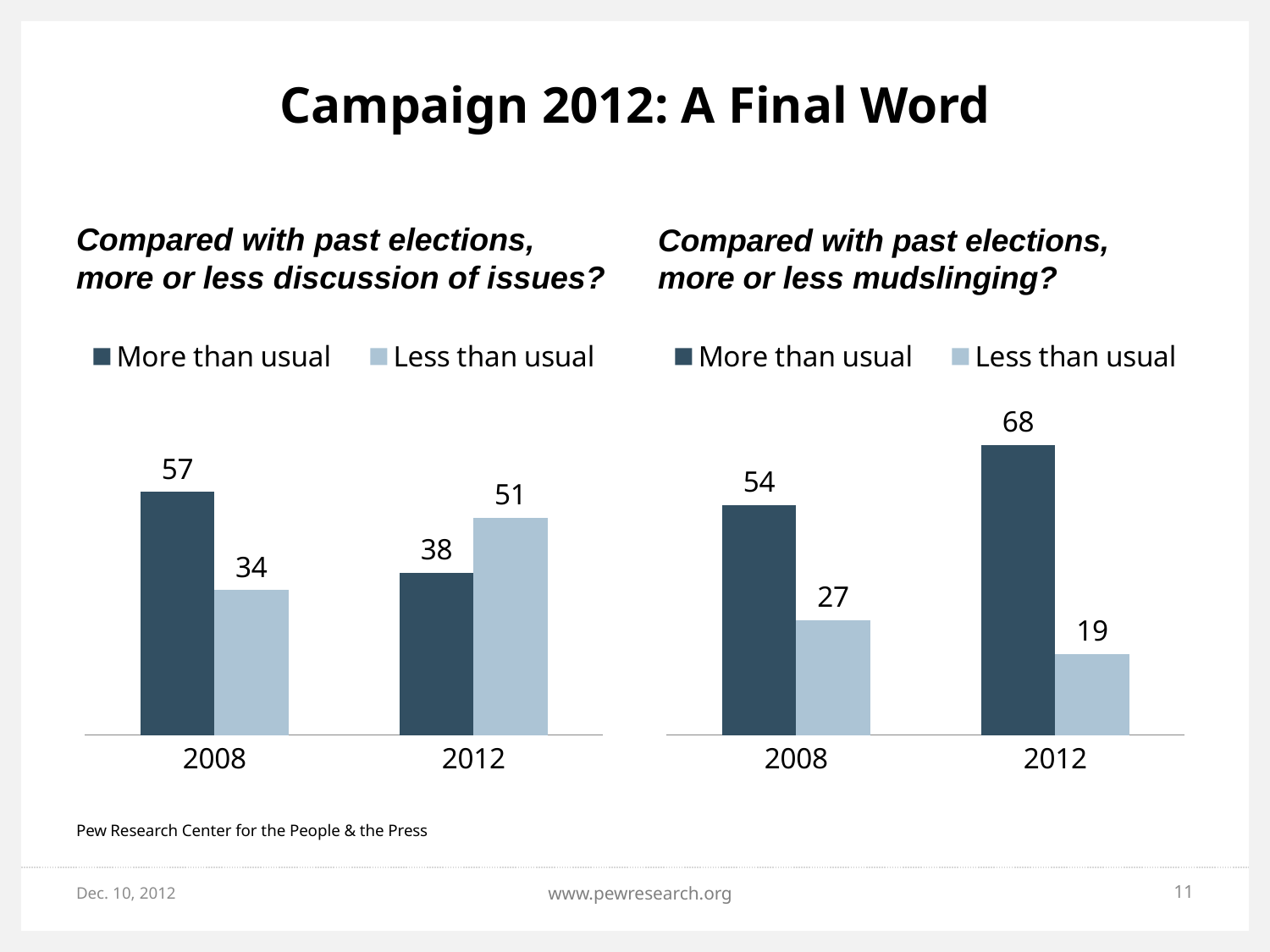
In the left chart (discussion of issues), which year has the lowest 'More than usual' value? 2012 What kind of chart is the left chart (discussion of issues)? Bar chart In the right chart (mudslinging), what is the difference between 'More than usual' in 2012 and 'More than usual' in 2008? 14 In the right chart (mudslinging), what is the value for 'Less than usual' in 2008? 27 In the left chart (discussion of issues), what is the value for 'Less than usual' in 2012? 51 In the left chart (discussion of issues), what is the difference between 'More than usual' and 'Less than usual' in 2008? 23 In the left chart (discussion of issues), which is larger in 2012: 'More than usual' or 'Less than usual'? Less than usual In the right chart (mudslinging), what is the value for 'More than usual' in 2012? 68 In the left chart (discussion of issues), what is the value for 'More than usual' in 2008? 57 How many series does the legend of the right chart (mudslinging) list? 2 In the right chart (mudslinging), does the 'Less than usual' value rise or fall from 2008 to 2012? Fall In the right chart (mudslinging), which year has the highest 'More than usual' value? 2012